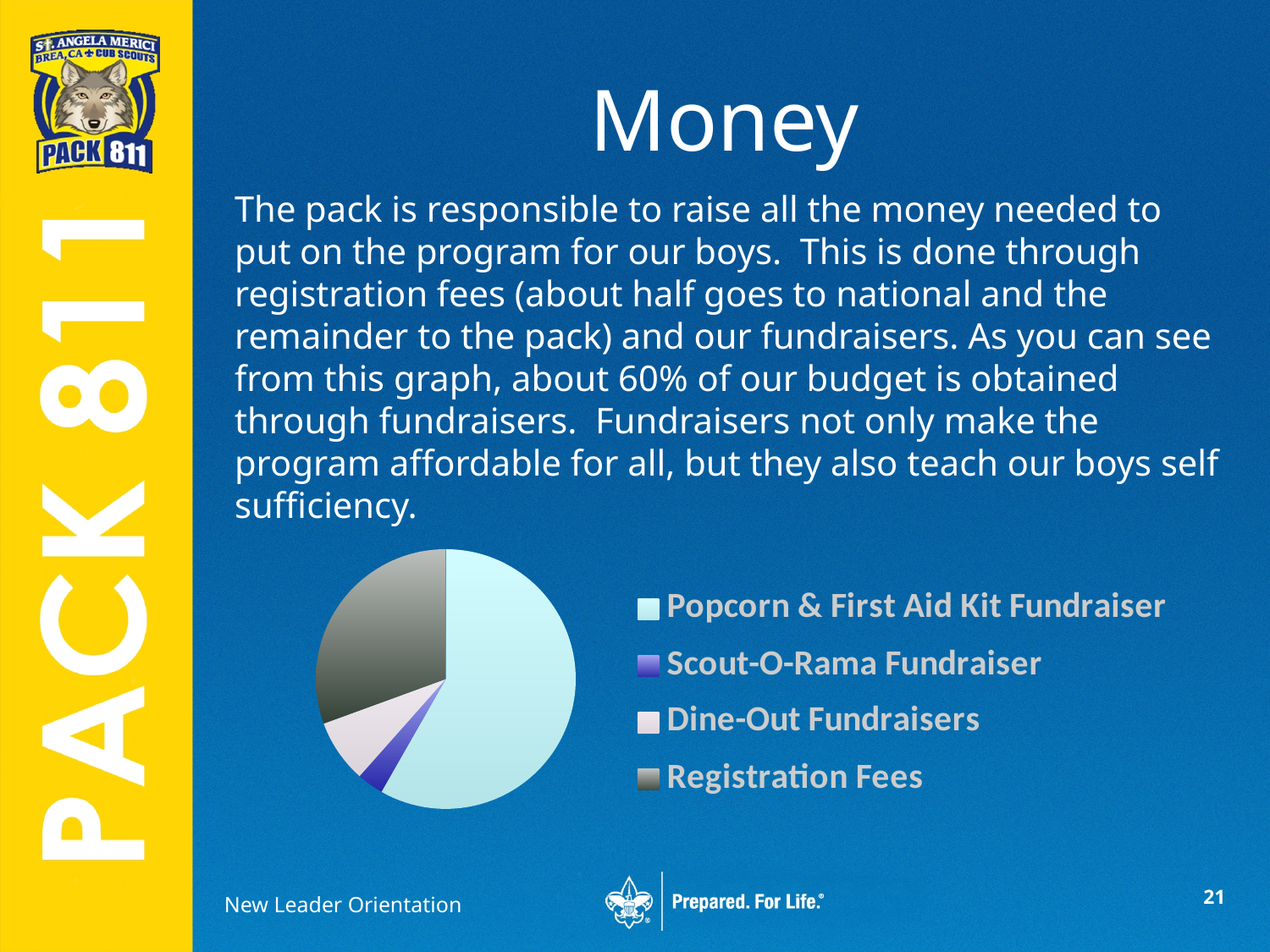
Which slice is larger: Registration Fees or Dine-Out Fundraisers? Registration Fees Which slice is larger: Popcorn & First Aid Kit Fundraiser or Registration Fees? Popcorn & First Aid Kit Fundraiser How many entries does the pie chart's legend list? 4 What colour is the Popcorn & First Aid Kit Fundraiser slice in the pie chart? light blue What kind of chart is shown on the slide? pie chart Which category has the smallest slice of the pie chart? Scout-O-Rama Fundraiser Which category has the largest slice of the pie chart? Popcorn & First Aid Kit Fundraiser Which legend entry is listed last in the pie chart's legend? Registration Fees Which category has the second-largest slice of the pie chart? Registration Fees Which slice is larger: Dine-Out Fundraisers or Scout-O-Rama Fundraiser? Dine-Out Fundraisers How many slices does the pie chart have? 4